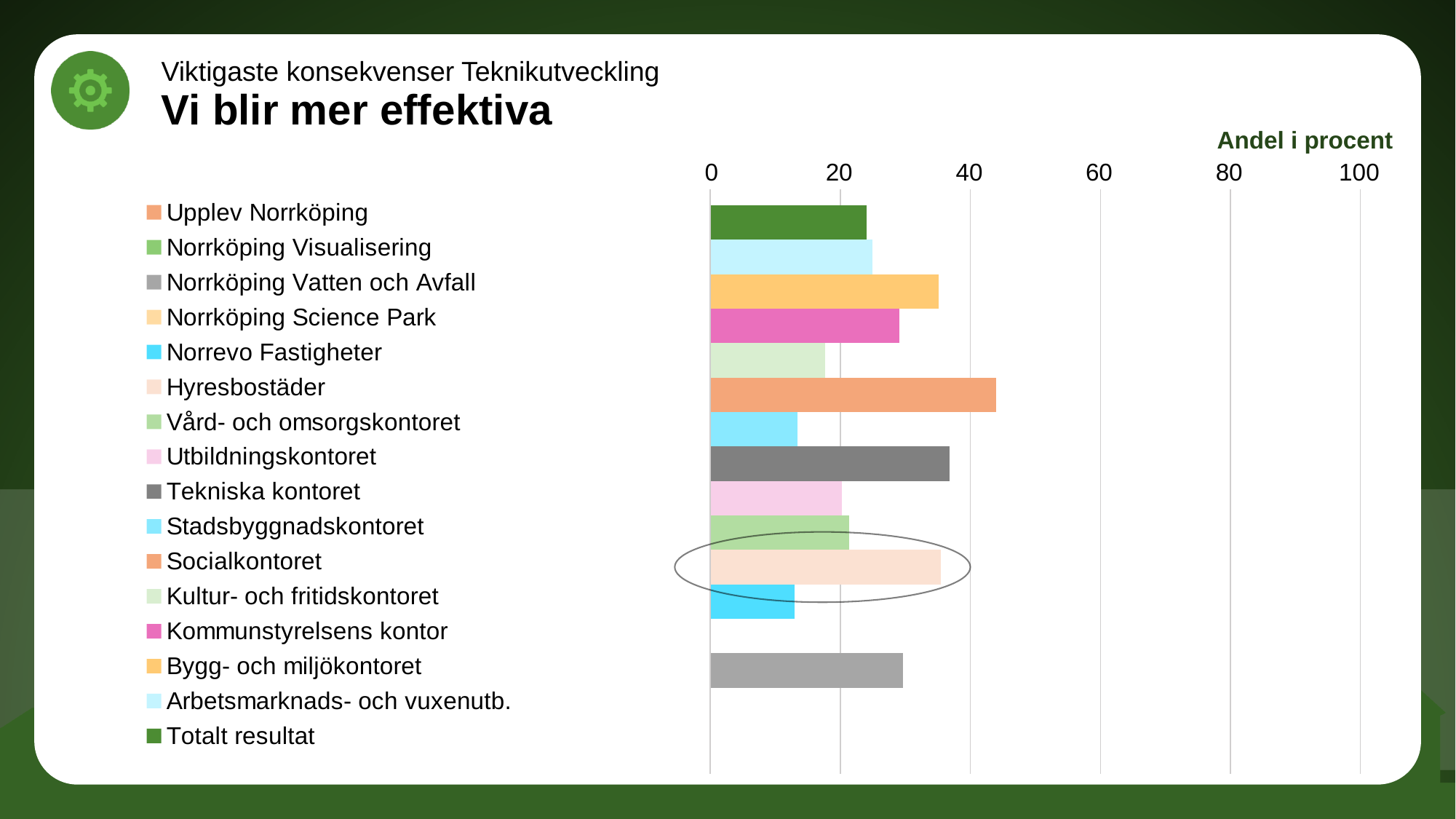
What is the highest value shown on the chart's horizontal axis? 100 Is the value for Kommunstyrelsens kontor greater or less than 20? greater Is the value for Totalt resultat greater or less than 20? greater Which legend entry has the longest bar in the chart? Socialkontoret What kind of chart is shown on the slide? bar chart Which has the larger value, Socialkontoret or Kultur- och fritidskontoret? Socialkontoret What is the title of the horizontal axis of the chart? Andel i procent How many entries does the chart's legend list? 16 Is the value for Kultur- och fritidskontoret greater or less than 20? less Which has the larger value, Tekniska kontoret or Totalt resultat? Tekniska kontoret